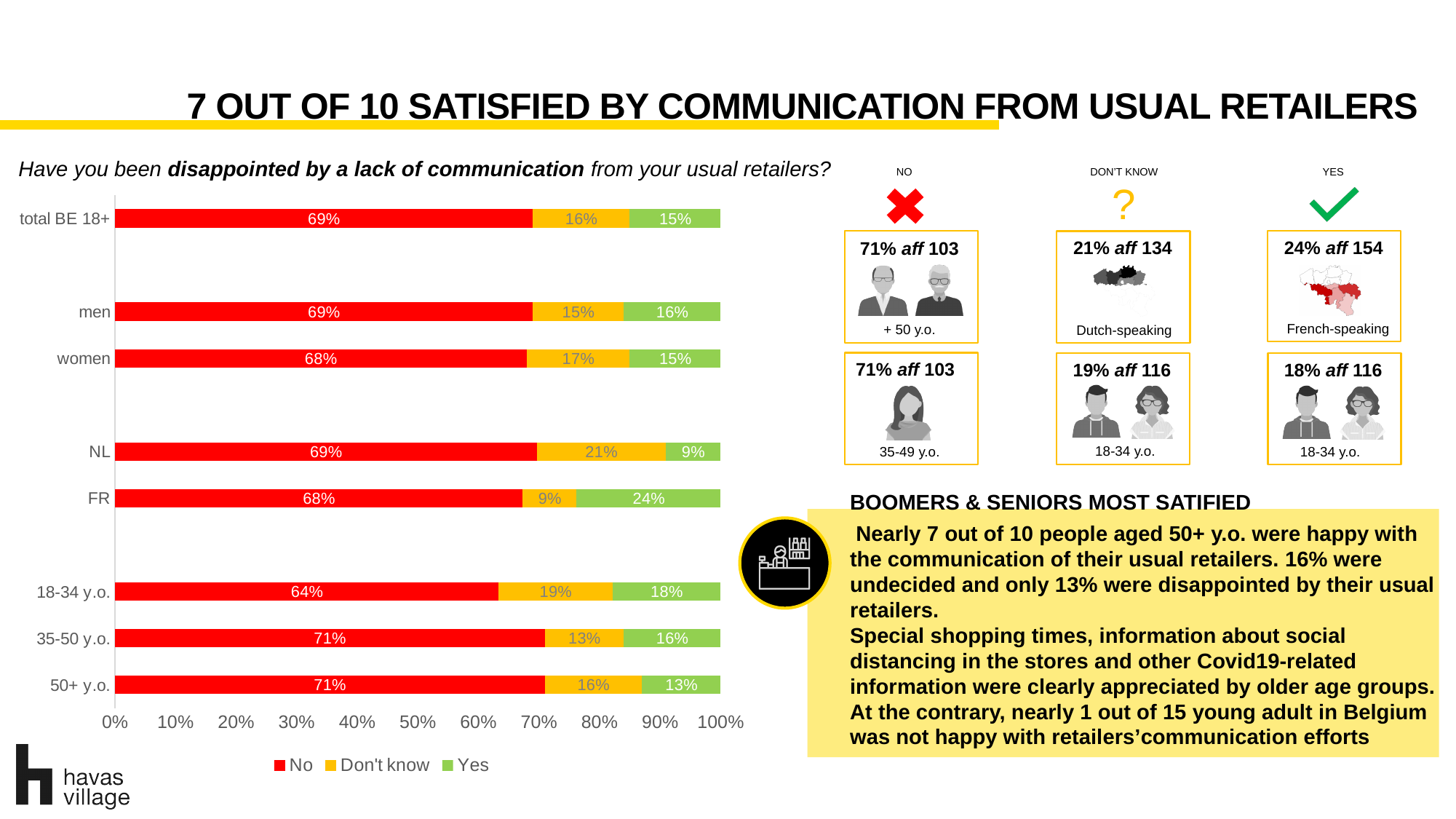
What is the "Yes" value for FR? 24% Which category has the lowest "Yes" value? NL How many categories are shown on the y axis of the chart? 8 Which category has the lowest "No" value? 18-34 y.o. Which category has the highest "Yes" value? FR What is the difference between the "Yes" values for FR and NL? 15% Which is larger, the "Don't know" value for NL or for FR? NL What is the "Don't know" value for NL? 21% What is the "Don't know" value for women? 17% How many series does the legend list? 3 What percentage of the 18-34 y.o. group answered "No"? 64% What kind of chart is shown on the slide? Stacked bar chart